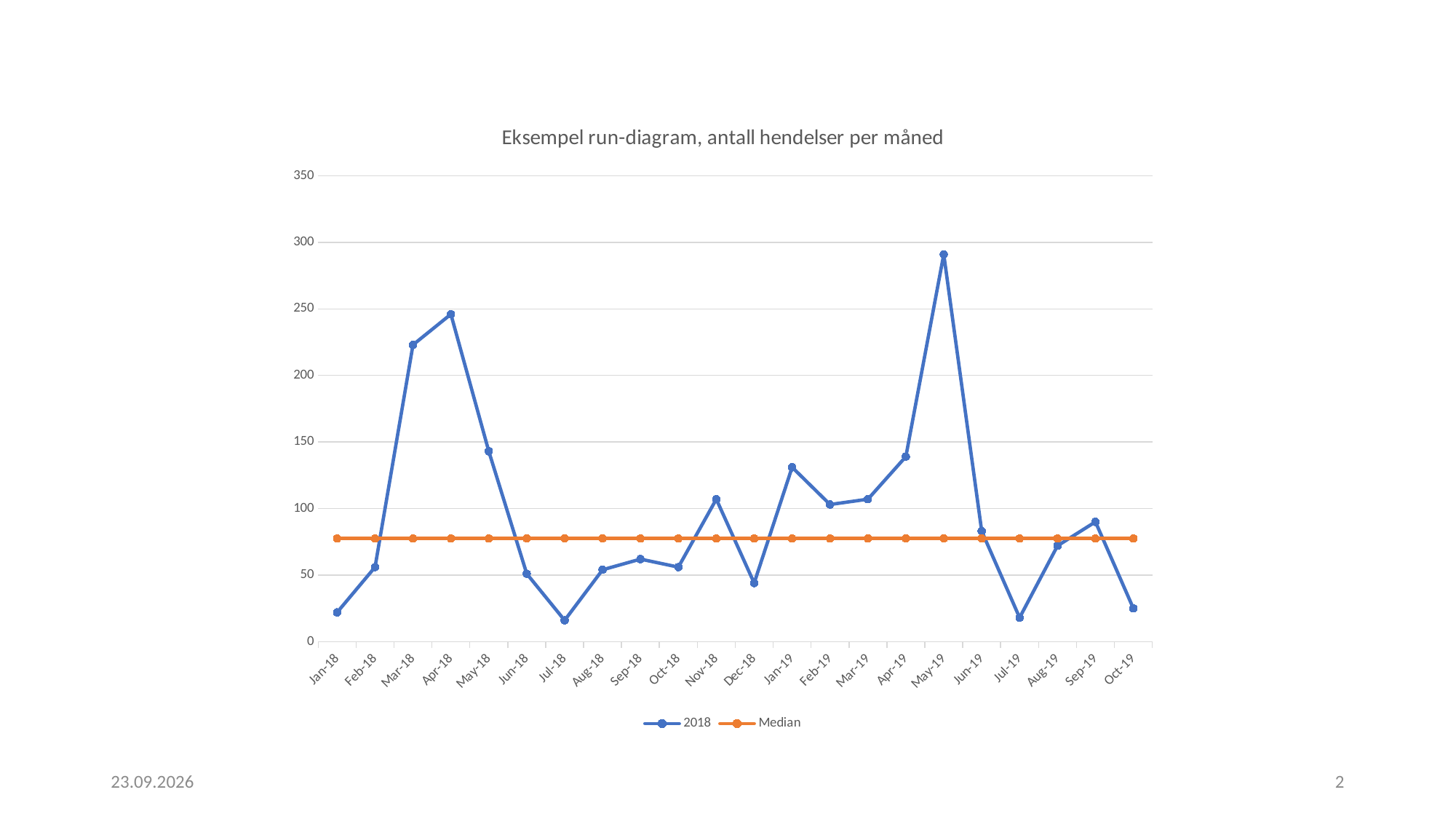
How many months are plotted along the x axis? 22 Is the value for May-19 greater or less than 250? greater What is the title of the chart? Eksempel run-diagram, antall hendelser per måned Is the value for Mar-18 greater or less than 200? greater Do the values rise or fall from Jan-18 to Apr-18? rise Is the value for Jan-18 greater or less than 50? less Which month has the highest value for the 2018 series? May-19 What kind of chart is shown on the slide? line chart How many series does the legend list? 2 What are the two entries in the legend? 2018 and Median Which is larger, the value for Apr-18 or the value for Mar-18? Apr-18